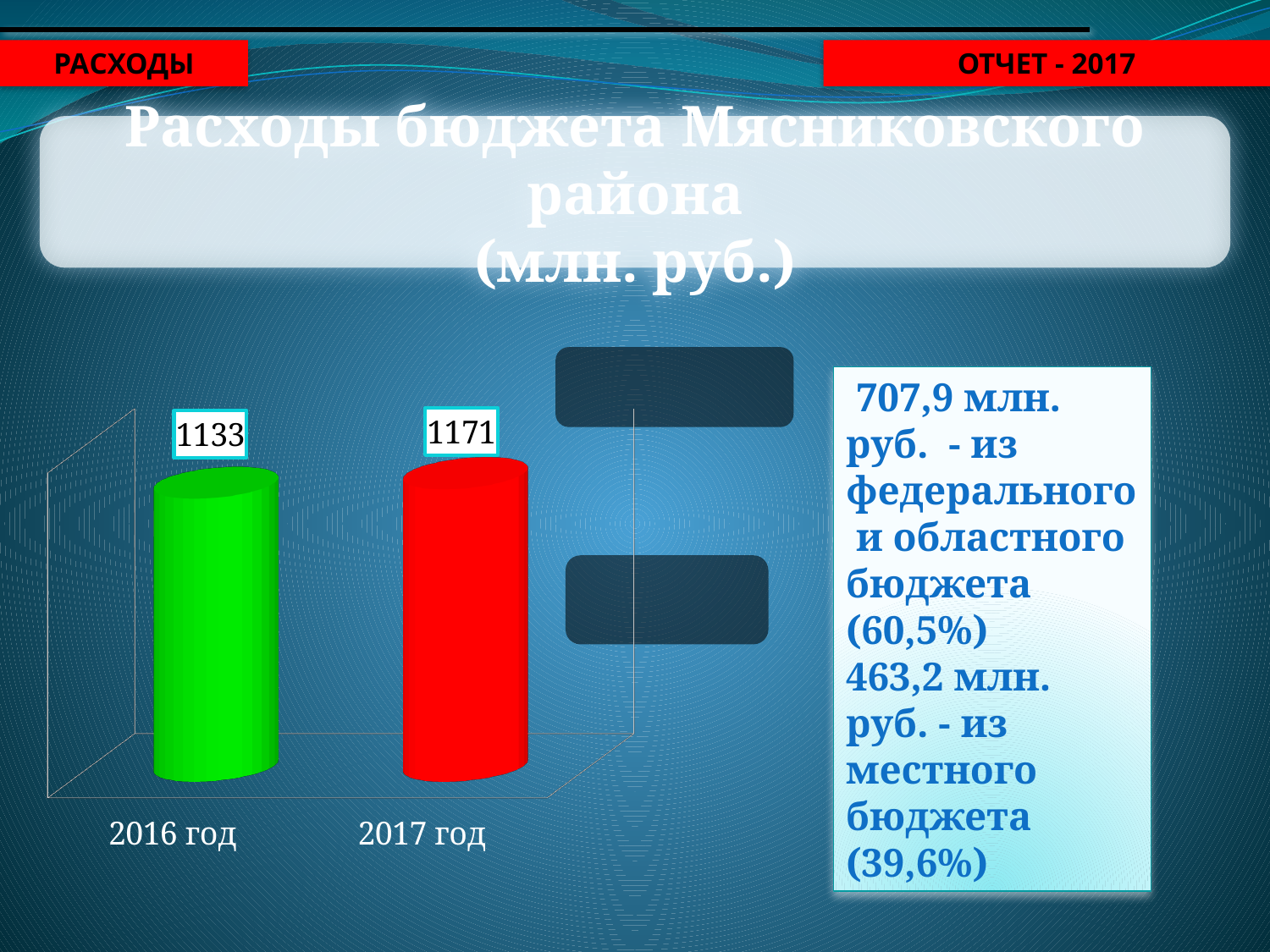
Is the value for 2017 год larger or smaller than the value for 2016 год? larger What is the difference between the values for 2017 год and 2016 год? 38 What is the value for 2016 год? 1133 What colour is the bar for 2016 год? green Which year has the lower value? 2016 год Which year has the higher value? 2017 год What is the value for 2017 год? 1171 Do the values rise or fall from 2016 год to 2017 год? rise What kind of chart is shown on the slide? bar chart What colour is the bar for 2017 год? red How many categories are shown in the chart? 2